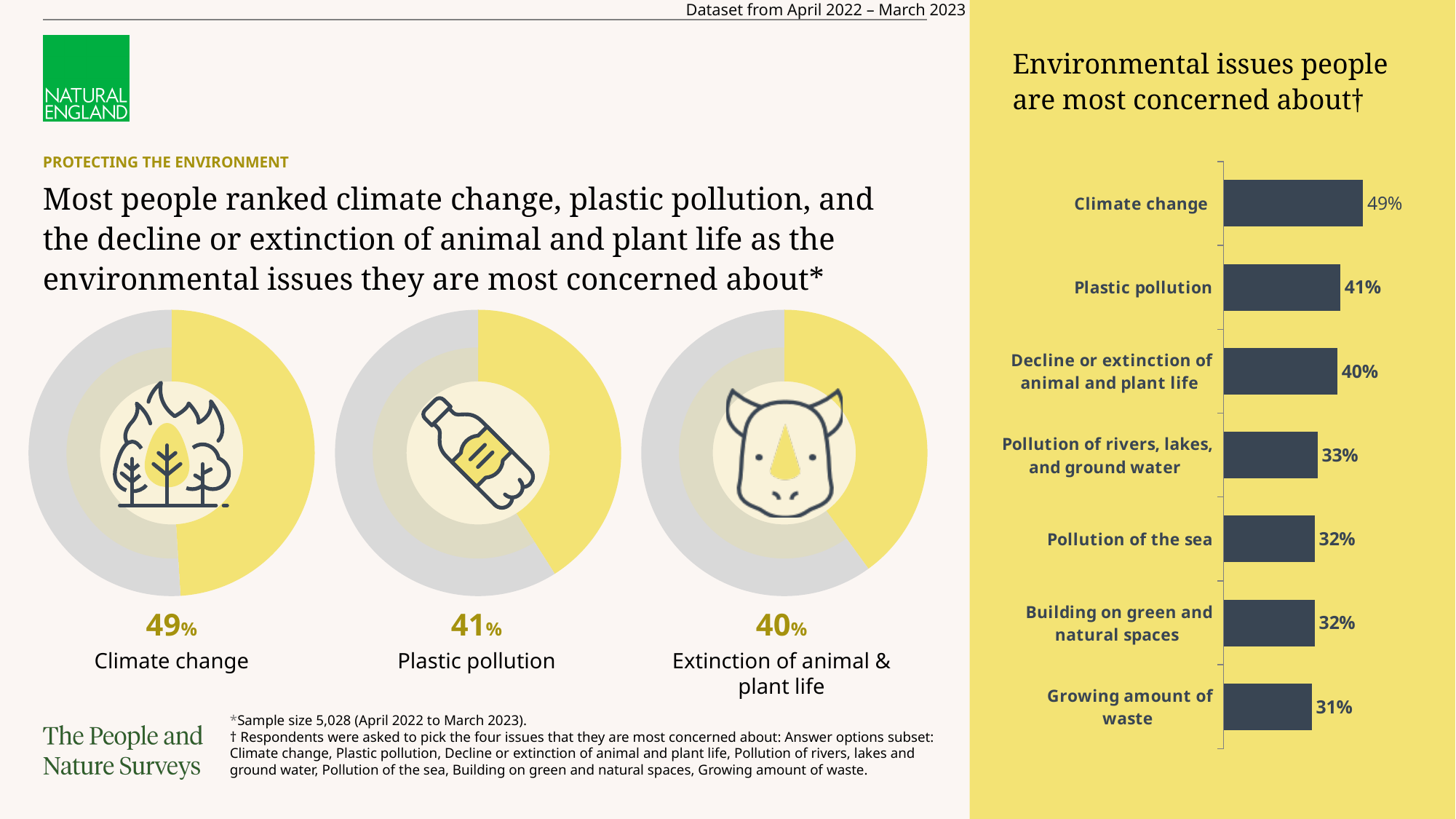
In the donut charts on the left of the slide, what percentage is shown for Plastic pollution? 41% In the bar chart 'Environmental issues people are most concerned about', which category has the lowest value? Growing amount of waste In the bar chart 'Environmental issues people are most concerned about', what is the difference between the values for Climate change and Plastic pollution? 8% What kind of chart is the chart titled 'Environmental issues people are most concerned about'? Bar chart In the donut charts on the left of the slide, what percentage is shown for Extinction of animal & plant life? 40% In the bar chart 'Environmental issues people are most concerned about', what is the value for Pollution of rivers, lakes, and ground water? 33% How many categories are shown in the bar chart 'Environmental issues people are most concerned about'? 7 In the bar chart 'Environmental issues people are most concerned about', which category has the highest value? Climate change In the bar chart 'Environmental issues people are most concerned about', do the values rise or fall going from the top bar to the bottom bar? Fall In the bar chart 'Environmental issues people are most concerned about', what is the value for Growing amount of waste? 31% What is the title of the bar chart on the right of the slide? Environmental issues people are most concerned about In the bar chart 'Environmental issues people are most concerned about', which is larger: Pollution of the sea or Decline or extinction of animal and plant life? Decline or extinction of animal and plant life